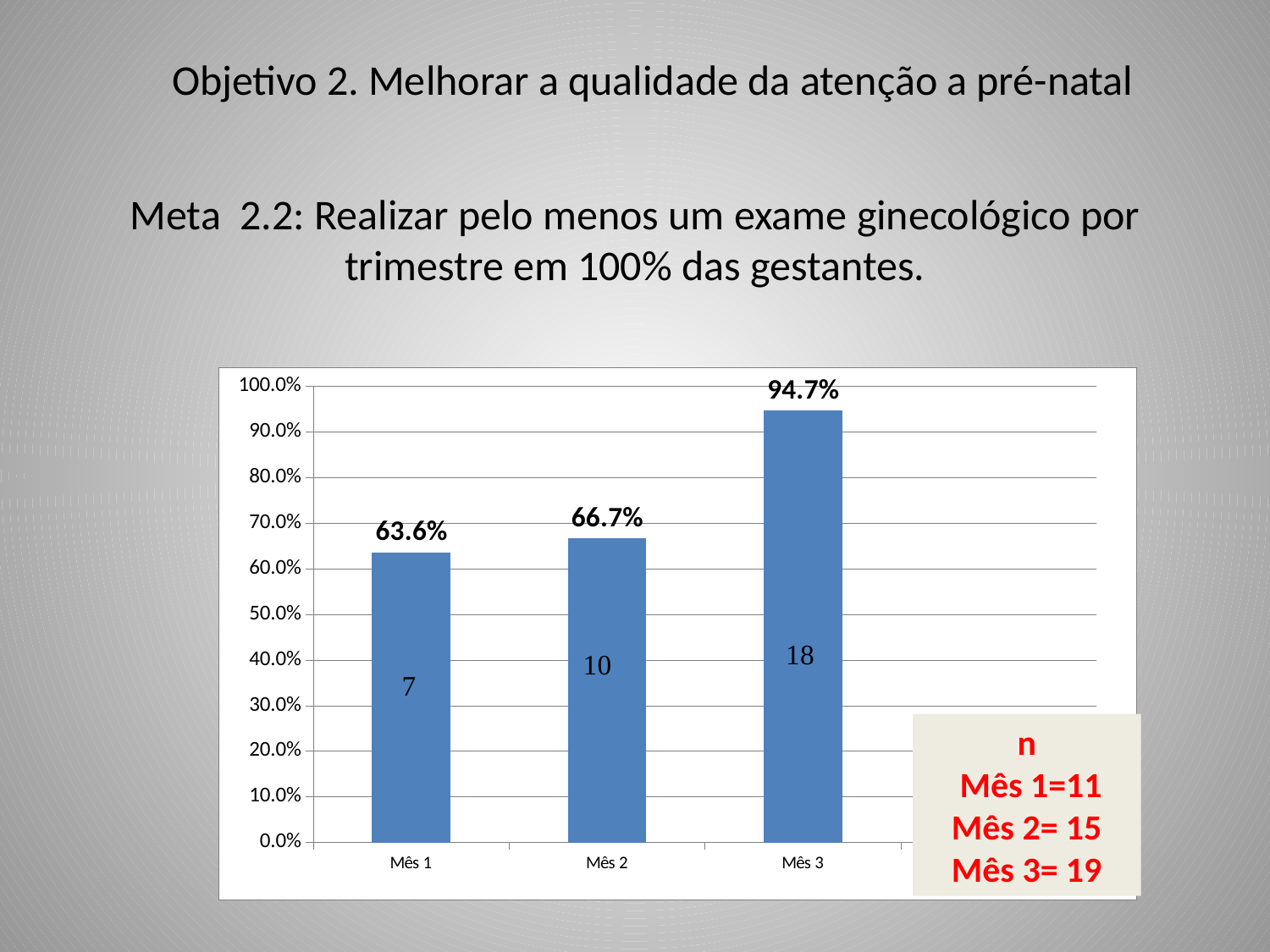
What is the percentage value shown for Mês 2? 66.7% Do the values rise or fall from Mês 1 to Mês 3? Rise What count is printed inside the bar for Mês 1? 7 What is the percentage value shown for Mês 1? 63.6% What type of chart is shown on the slide? Bar chart Which month has the lowest percentage? Mês 1 Which is larger, the value for Mês 2 or the value for Mês 3? Mês 3 What is the percentage value shown for Mês 3? 94.7% Which month has the highest percentage? Mês 3 What count is printed inside the bar for Mês 3? 18 What is the difference in percentage points between Mês 3 and Mês 1? 31.1 How many bars are shown in the chart? 3